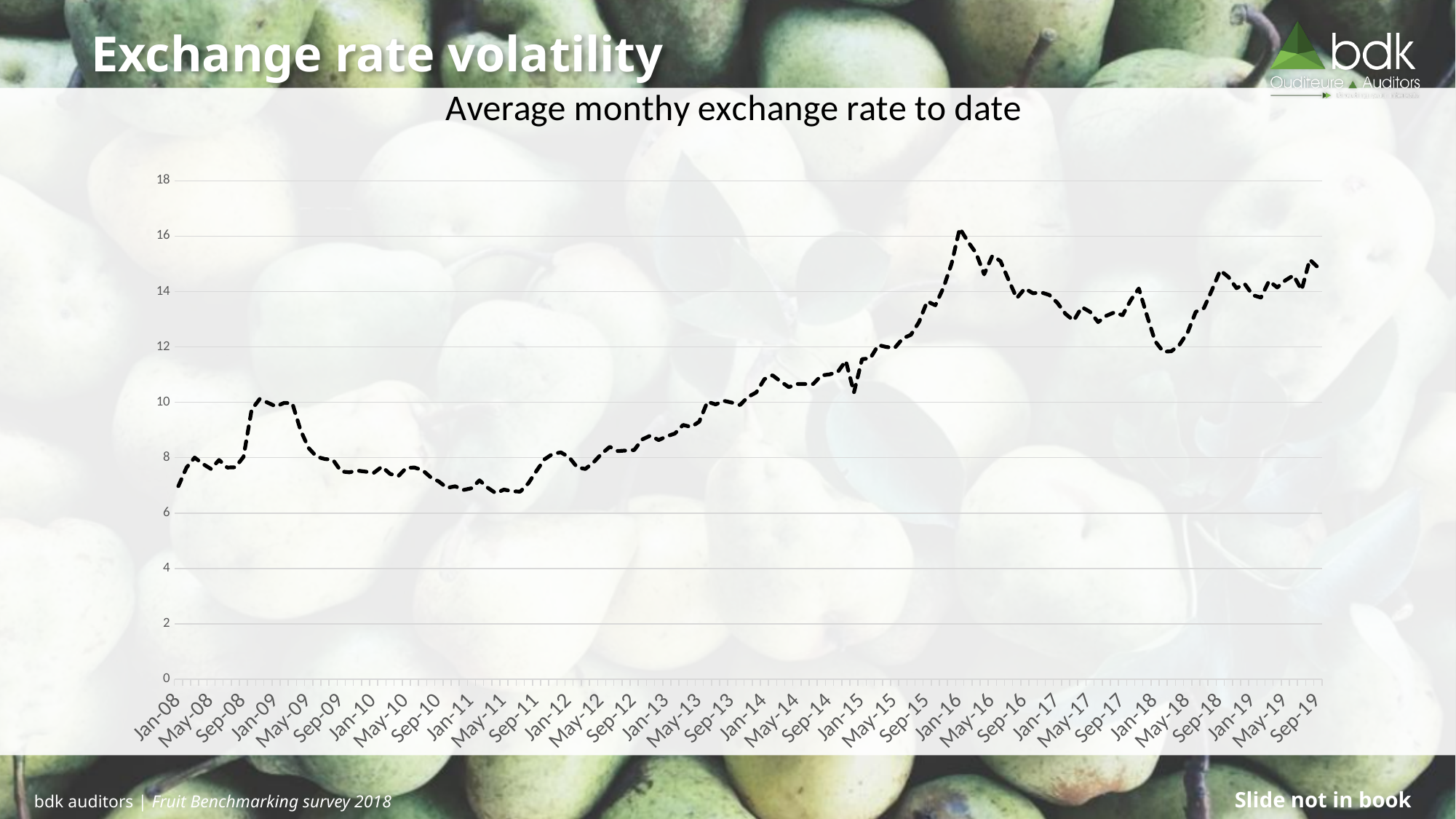
Is the value for May-18 greater or less than 14? less Is the value for Jan-08 greater or less than 8? less Around which labelled month does the line reach its highest value? Jan-16 What kind of chart is shown on the slide? line chart What is the title of the chart? Average monthy exchange rate to date Overall, does the exchange rate rise or fall from Jan-08 to Sep-19? rise Is the value for Sep-12 greater or less than 10? less Is the line in the chart drawn solid or dashed? dashed How many month labels are shown on the x axis? 36 Which is larger, the value for Sep-19 or the value for Jan-08? Sep-19